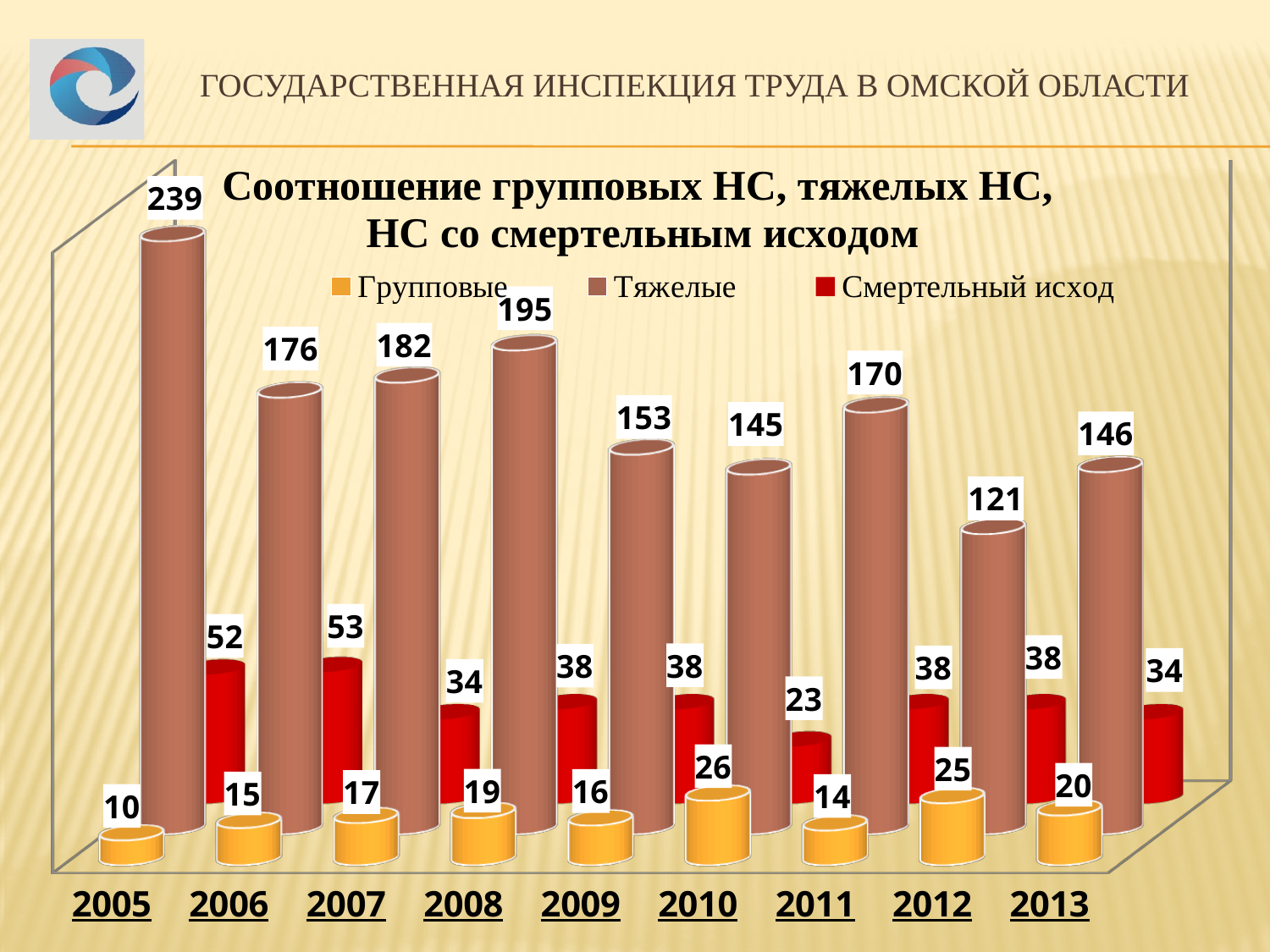
In which year is the Тяжелые value the lowest? 2012 What is the value for Групповые in 2010? 26 What is the value for Тяжелые in 2005? 239 What is the value for Смертельный исход in 2011? 38 In which year is the Групповые value the highest? 2010 What is the difference between the Групповые values for 2012 and 2005? 15 What kind of chart is shown on the slide? Bar chart How many years are shown on the x axis? 9 Which is larger: the Смертельный исход value for 2006 or for 2008? 2006 What is the difference between the Тяжелые values for 2005 and 2013? 93 How many series does the legend list? 3 Which series is shown in red in the legend? Смертельный исход